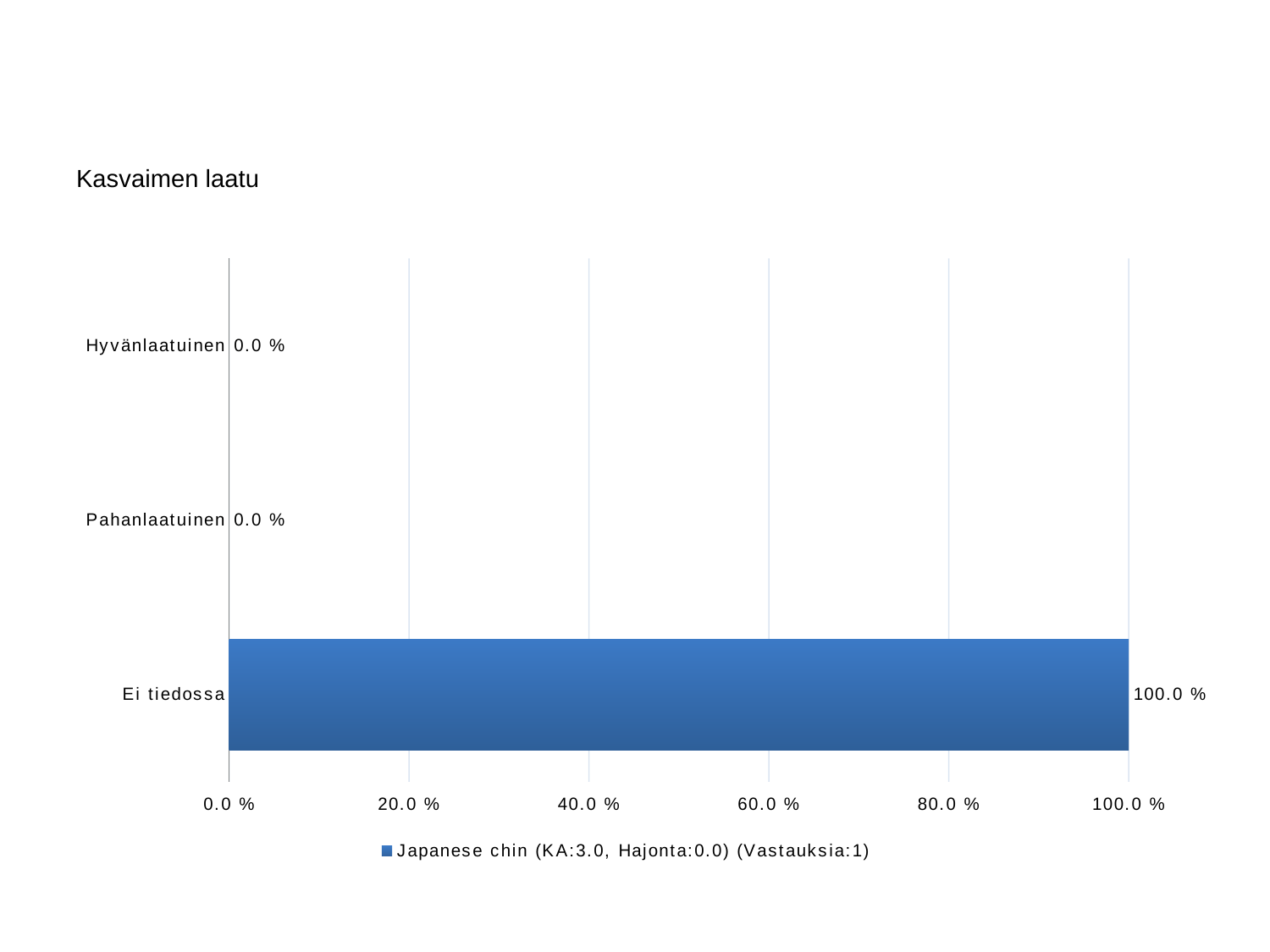
What is the title of the chart? Kasvaimen laatu Is the value for Ei tiedossa greater or less than 80.0 %? greater What is the value for Hyvänlaatuinen? 0.0 % What is the value for Ei tiedossa? 100.0 % What kind of chart is shown on the slide? bar chart How many categories are shown on the chart? 3 Which is larger, the value for Ei tiedossa or the value for Hyvänlaatuinen? Ei tiedossa What is the value for Pahanlaatuinen? 0.0 % What is the difference between the values for Ei tiedossa and Pahanlaatuinen? 100.0 % How many series does the legend list? 1 What is the legend entry for the series? Japanese chin (KA:3.0, Hajonta:0.0) (Vastauksia:1) Which category has the highest value? Ei tiedossa